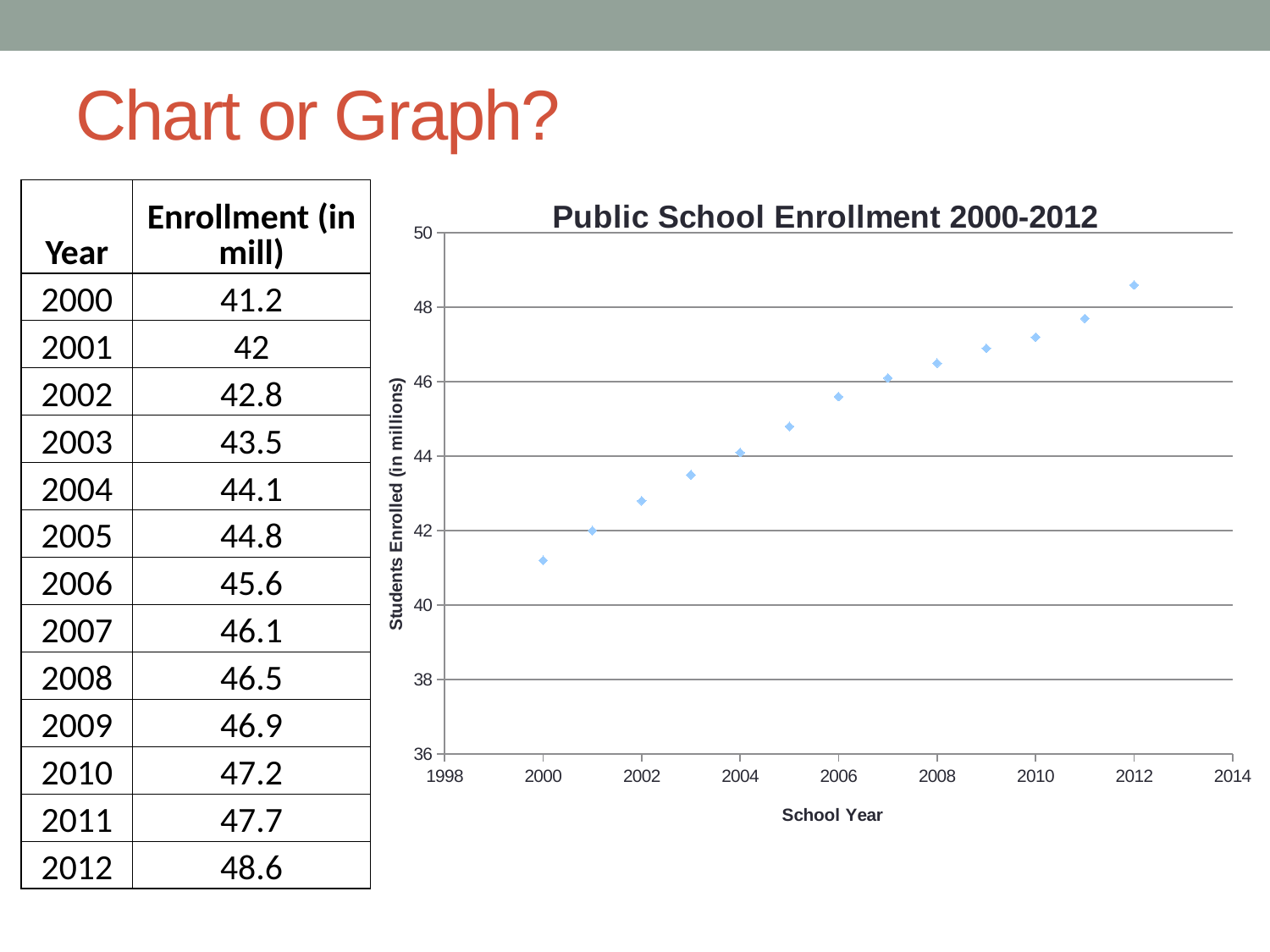
What is the enrollment value plotted for 2000? 41.2 What is the enrollment value plotted for 2006? 45.6 How many data points are plotted in the chart? 13 What is the title of the chart? Public School Enrollment 2000-2012 What is the enrollment value plotted for 2012? 48.6 Which year has the lowest enrollment in the chart? 2000 What is the difference between the enrollment in 2012 and in 2000? 7.4 What kind of chart is shown on the slide? scatter chart Which year has the larger enrollment, 2005 or 2009? 2009 Do the enrollment values rise or fall from 2000 to 2012? rise Which year has the highest enrollment in the chart? 2012 Is the value for 2006 greater or less than 44? greater